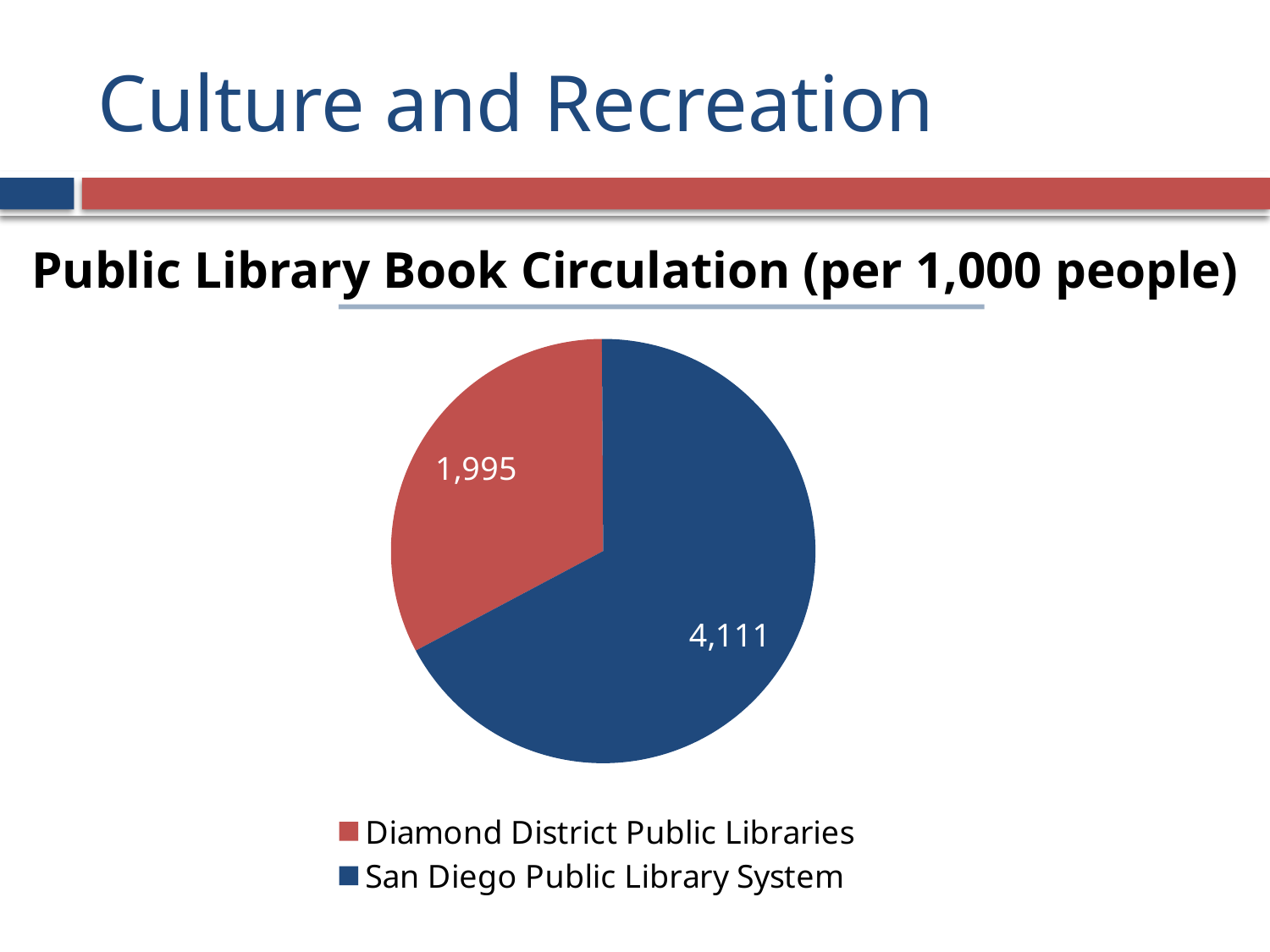
Which category has the smallest slice of the pie? Diamond District Public Libraries What is the title of the chart? Public Library Book Circulation (per 1,000 people) What colour is the slice for San Diego Public Library System? Blue What is the total of the two values shown in the pie chart? 6,106 How many slices does the pie chart have? 2 Which category has the largest slice of the pie? San Diego Public Library System What is the value for San Diego Public Library System? 4,111 What is the difference between the San Diego Public Library System value and the Diamond District Public Libraries value? 2,116 How many entries does the legend list? 2 What type of chart is shown on the slide? Pie chart What is the value for Diamond District Public Libraries? 1,995 Which is larger, the value for Diamond District Public Libraries or the value for San Diego Public Library System? San Diego Public Library System